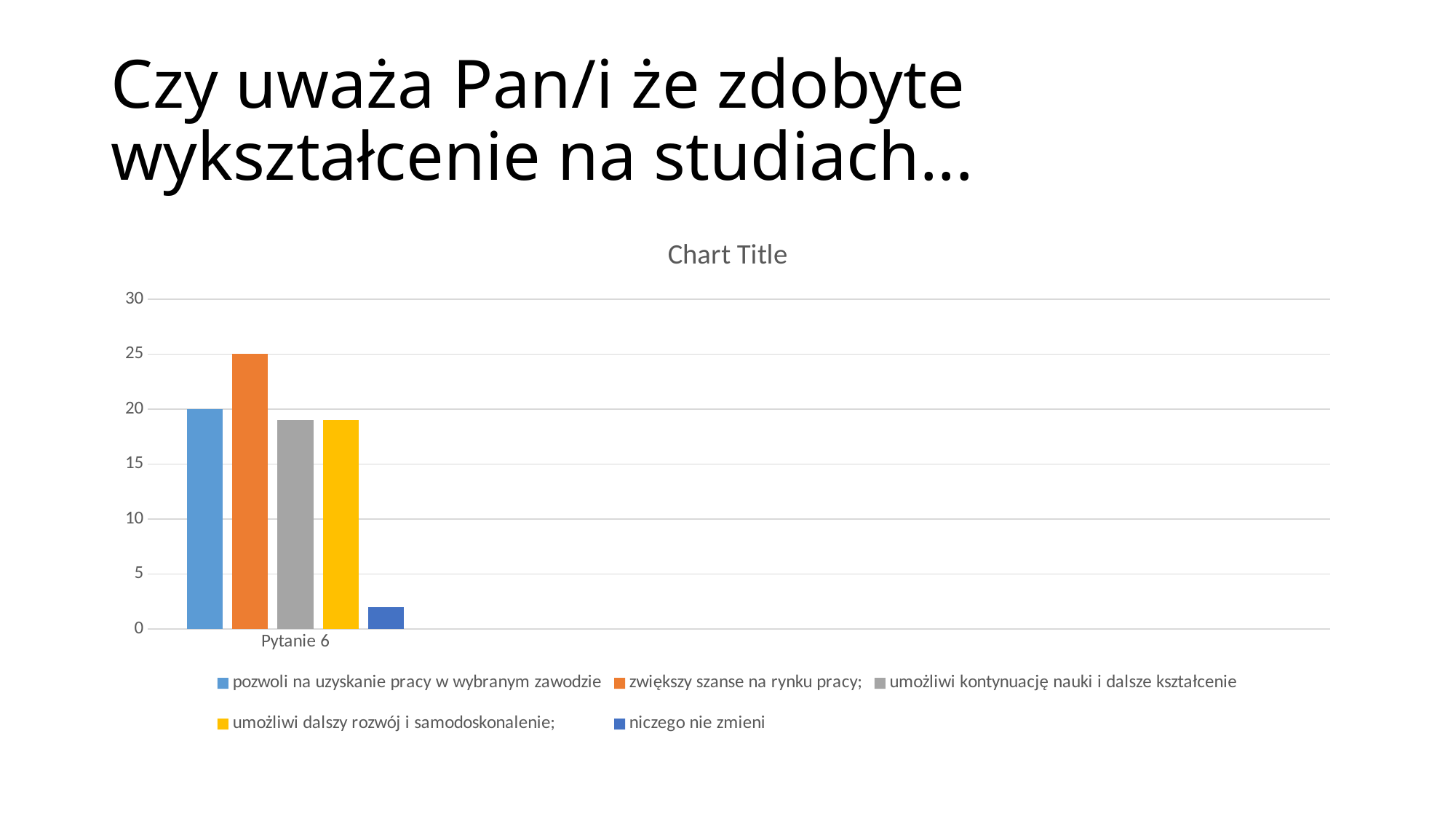
Is the value for 'umożliwi kontynuację nauki i dalsze kształcenie' greater or less than 20? less Is the value for 'niczego nie zmieni' greater or less than 5? less Which series has the lowest value for Pytanie 6? niczego nie zmieni What is the value for 'zwiększy szanse na rynku pracy;'? 25 Which series has the highest value for Pytanie 6? zwiększy szanse na rynku pracy; What is the value for 'pozwoli na uzyskanie pracy w wybranym zawodzie'? 20 What is the difference between the values for 'zwiększy szanse na rynku pracy;' and 'pozwoli na uzyskanie pracy w wybranym zawodzie'? 5 Which is larger: the value for 'zwiększy szanse na rynku pracy;' or the value for 'umożliwi dalszy rozwój i samodoskonalenie;'? zwiększy szanse na rynku pracy; How many series does the legend list? 5 What is the title shown above the chart? Chart Title How many categories are shown on the x axis? 1 What kind of chart is shown on the slide? bar chart